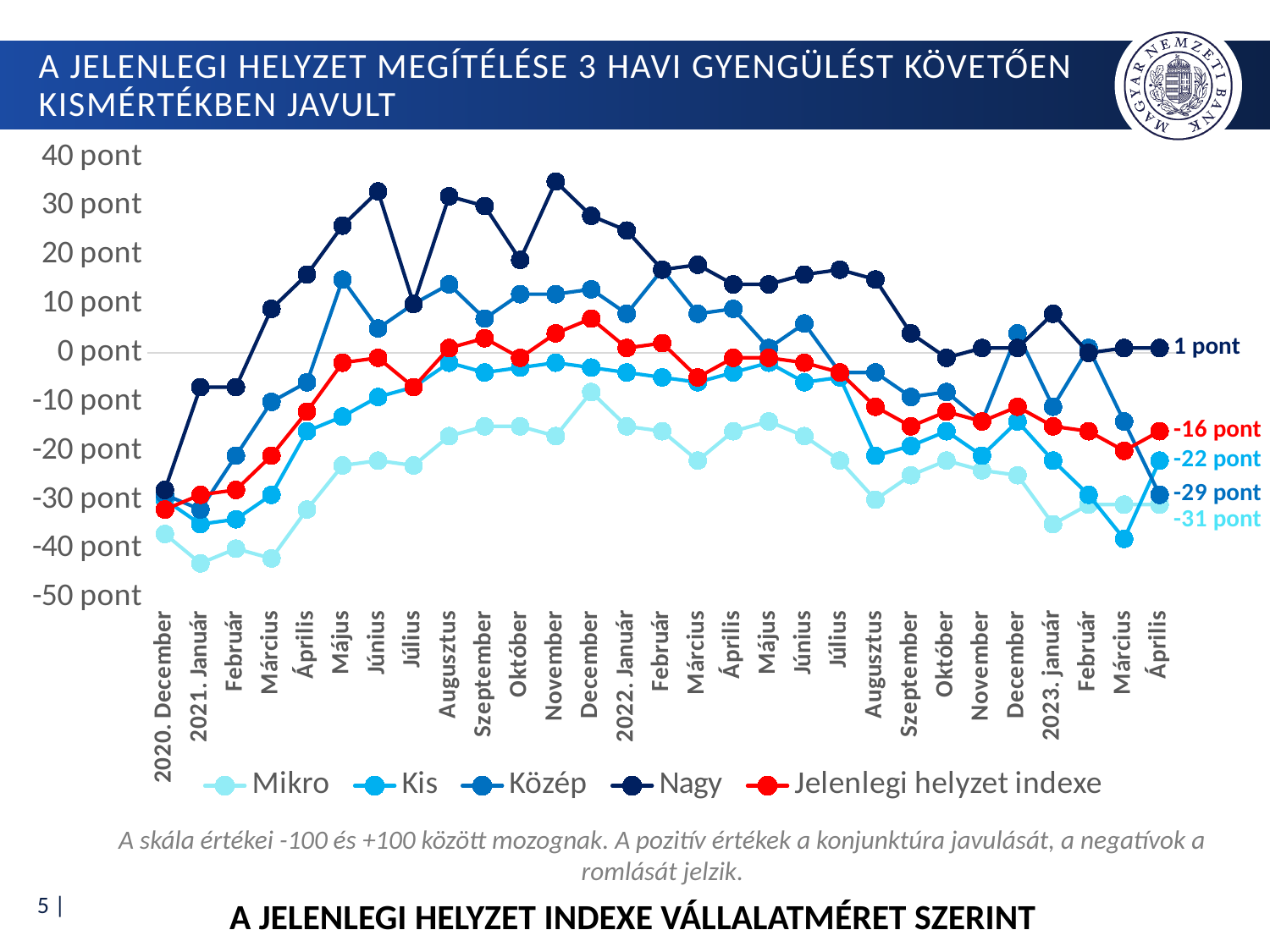
What is the value of the Nagy series in 2023 Április? 1 pont Which series has the lowest value in 2023 Április? Mikro Which series has the highest value in 2023 Április? Nagy What is the value of the Közép series in 2023 Április? -29 pont Is the value of the Nagy series in 2021 Június greater or less than 30 pont? greater What is the difference between the Nagy and Mikro values in 2023 Április? 32 pont How many series does the legend list? 5 What is the value of the Mikro series in 2023 Április? -31 pont In 2023 Április, which is higher: the Kis series or the Közép series? Kis What is the value of the Jelenlegi helyzet indexe series in 2023 Április? -16 pont What is the value of the Kis series in 2023 Április? -22 pont What kind of chart is shown on the slide? Line chart